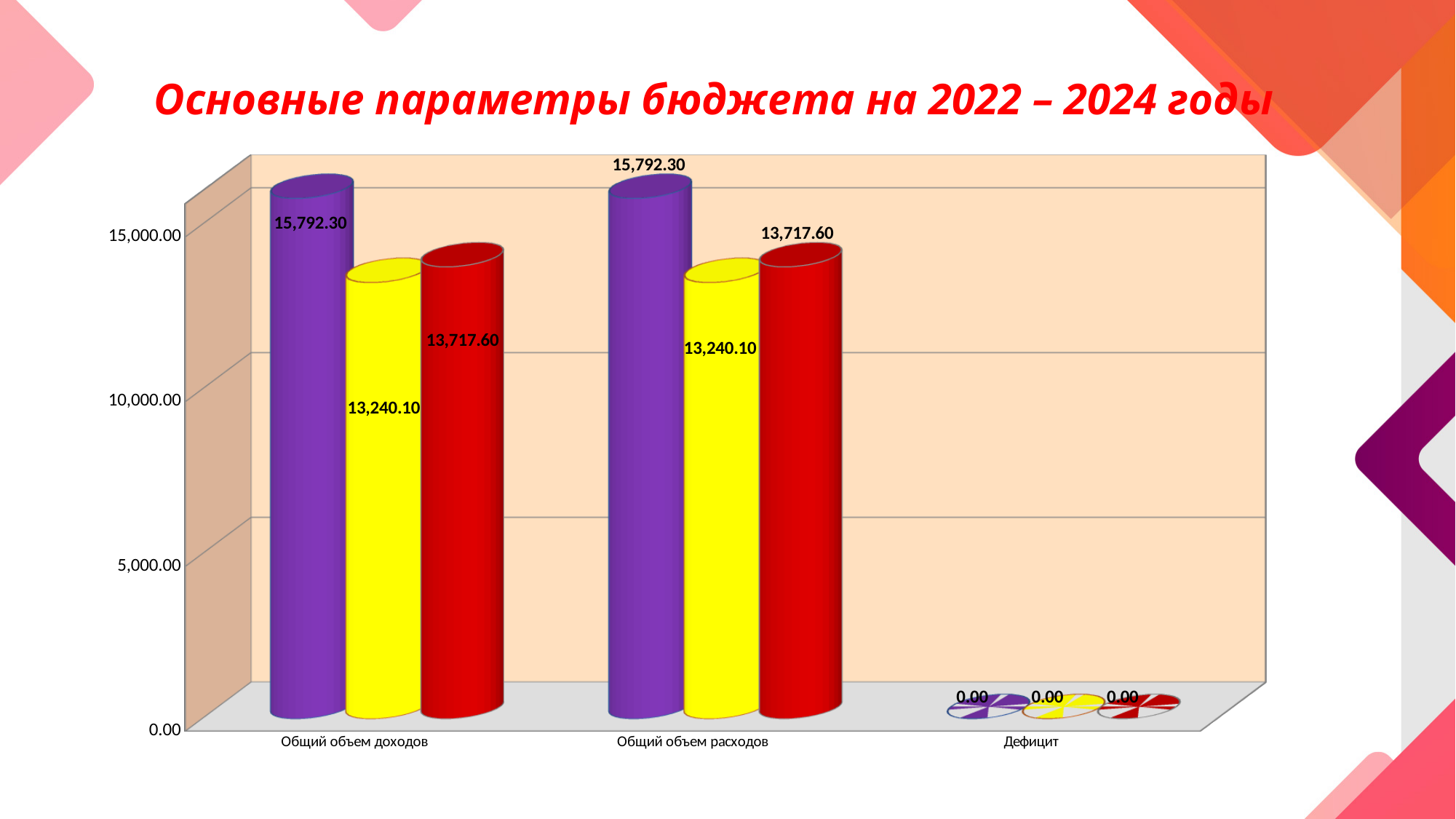
How many categories are shown on the x axis? 3 What is the difference between the red bar and the yellow bar for Общий объем расходов? 477.50 Which is larger for Общий объем расходов: the red bar or the yellow bar? The red bar What is the title of the slide? Основные параметры бюджета на 2022 – 2024 годы What is the difference between the purple bar and the yellow bar for Общий объем доходов? 2,552.20 What is the value of the purple bar for Общий объем доходов? 15,792.30 What is the value of the yellow bar for Общий объем расходов? 13,240.10 Which coloured bar is the highest within the Общий объем расходов category? Purple Which coloured bar is the lowest within the Общий объем доходов category? Yellow What value is shown for the bars in the Дефицит category? 0.00 What is the value of the red bar for Общий объем доходов? 13,717.60 What kind of chart is shown on the slide? Bar chart